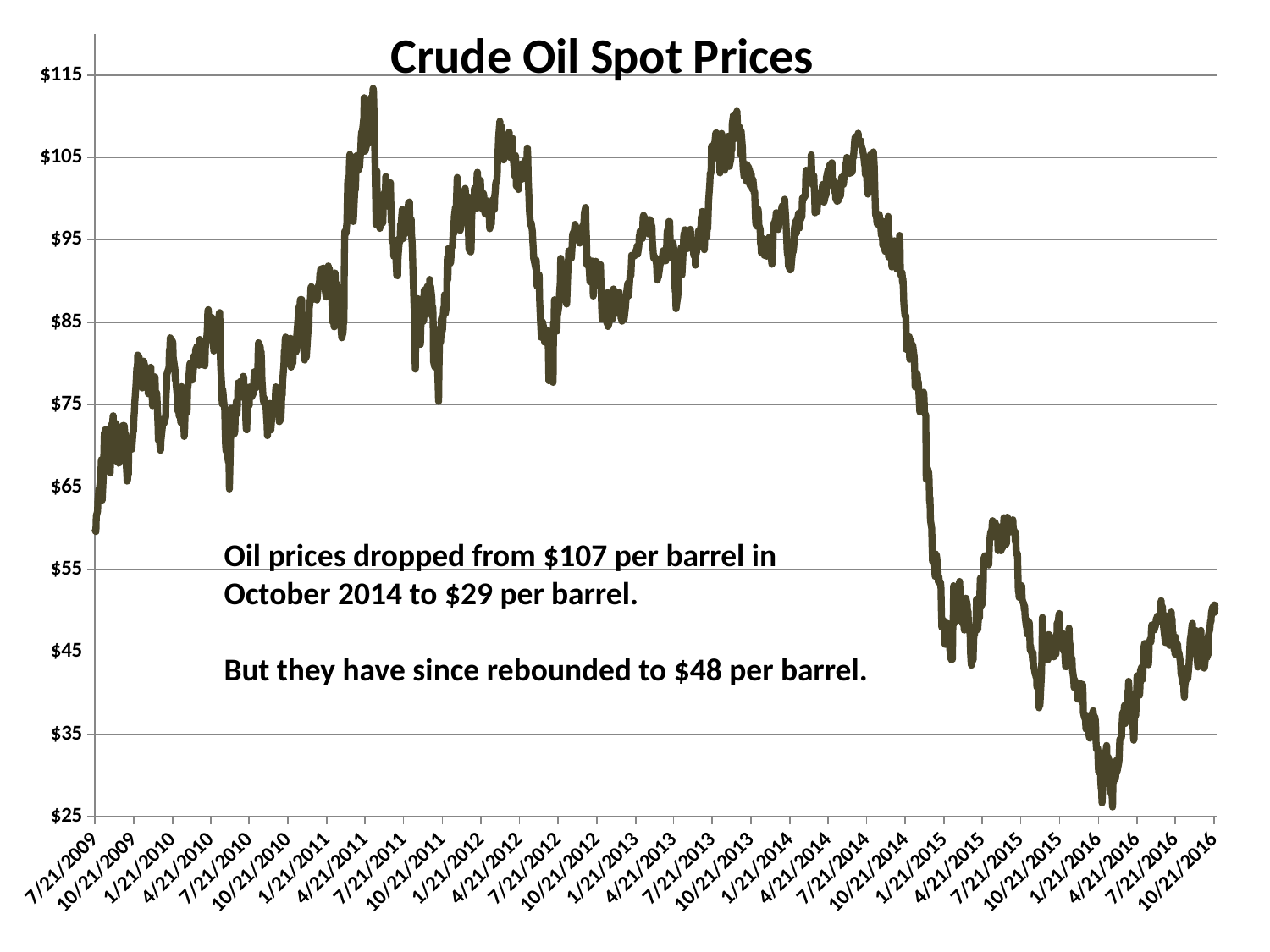
Is the value at 7/21/2014 greater or less than $95? greater Which is larger, the value at 4/21/2011 or the value at 4/21/2016? 4/21/2011 According to the text on the chart, what price per barrel have oil prices rebounded to? $48 According to the text on the chart, what was the oil price per barrel in October 2014? $107 According to the text on the chart, what price per barrel did oil drop to after October 2014? $29 What kind of chart is shown on the slide? line chart Is the value at 10/21/2016 greater or less than $45? greater Do the values rise or fall between 7/21/2014 and 1/21/2015? fall What is the title of the chart? Crude Oil Spot Prices Is the value at 7/21/2009 greater or less than $65? less In which year does the line reach its lowest point? 2016 Using the prices stated in the chart's text, how much did oil fall from its October 2014 price of $107 to its low of $29? $78